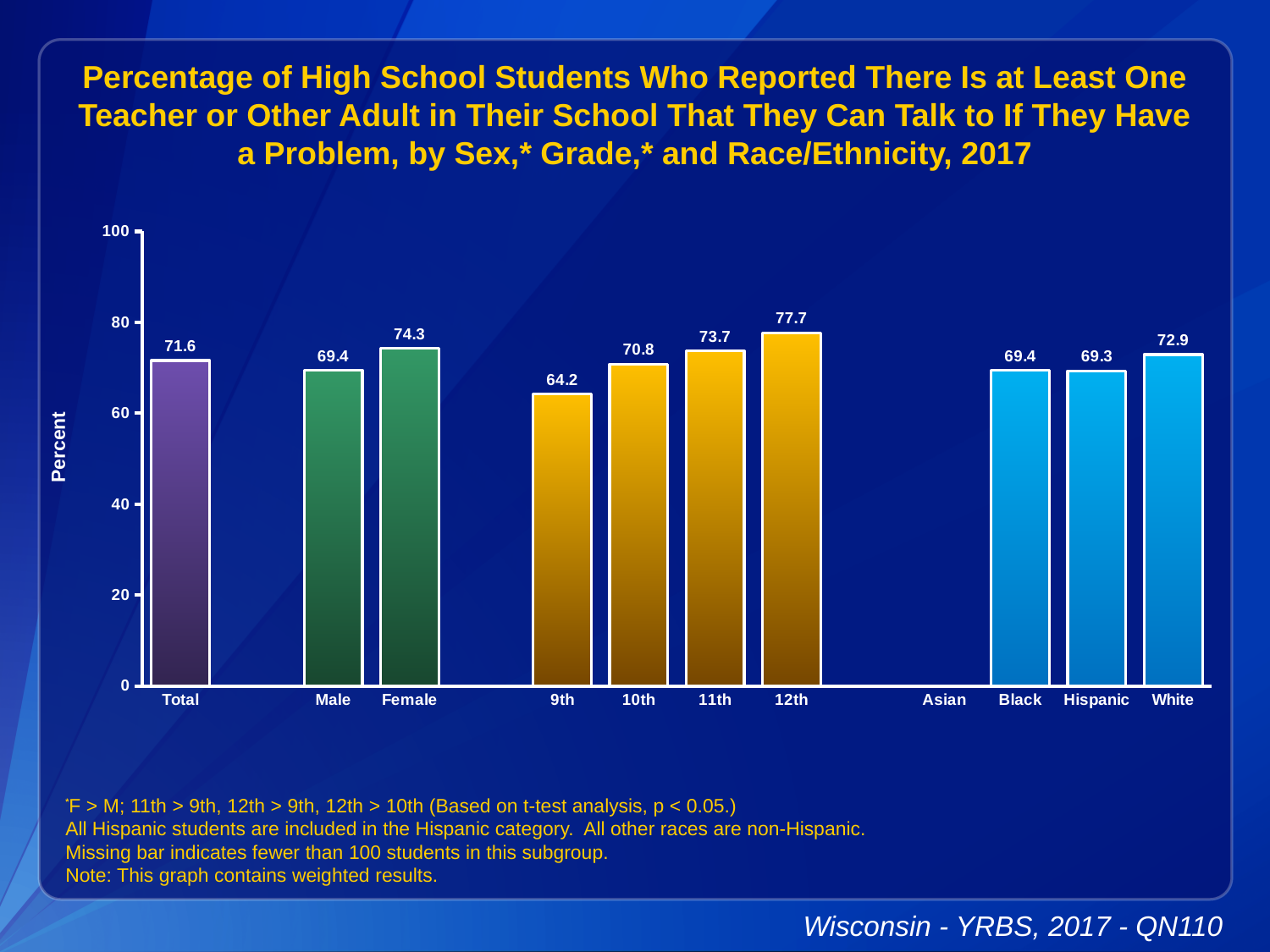
What is the value for White? 72.9 Which category has the highest value? 12th What kind of chart is shown? bar chart What is the value for 9th grade? 64.2 Which category label has no bar shown? Asian What is the value for Female? 74.3 What is the difference between the Female and Male values? 4.9 What is the value for Total? 71.6 What is the difference between the 12th and 9th grade values? 13.5 Do the values rise or fall from 9th to 12th grade? rise Which category with a bar has the lowest value? 9th Which is larger, the value for 11th or the value for 10th? 11th